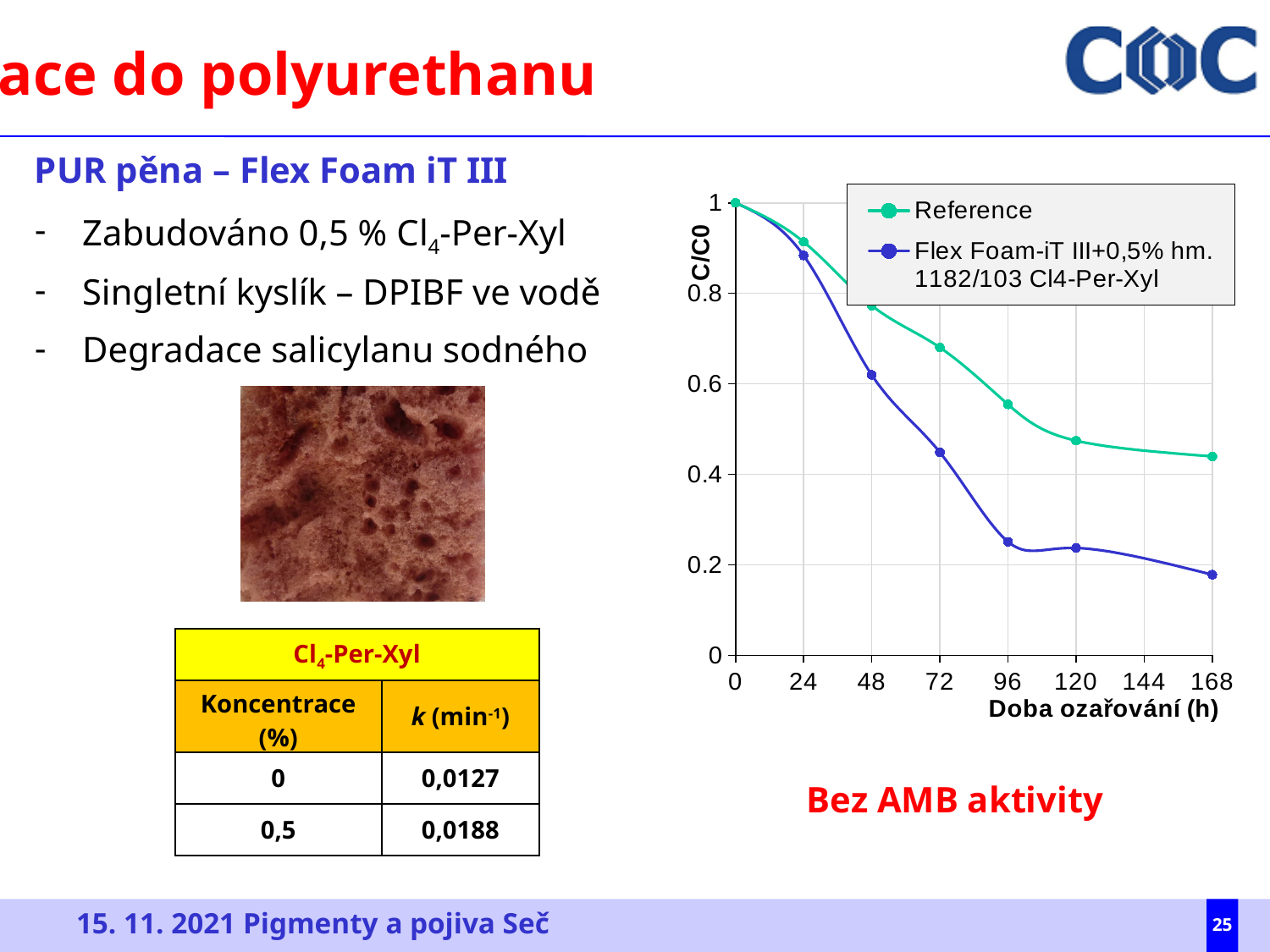
How many data points are plotted for the Reference series? 7 Is the C/C0 value of the Flex Foam-iT III+0,5% hm. 1182/103 Cl4-Per-Xyl series at 168 h greater or less than 0.2? less At 96 h, which series has the higher C/C0 value, Reference or Flex Foam-iT III+0,5% hm. 1182/103 Cl4-Per-Xyl? Reference Does the C/C0 value of the Reference series rise or fall as the irradiation time increases? fall What is the C/C0 value of both series at 0 h? 1 What is the label of the x axis of the chart? Doba ozařování (h) Is the C/C0 value of the Reference series at 48 h greater or less than 0.8? less What is the label of the y axis of the chart? C/C0 Is the C/C0 value of the Reference series at 168 h greater or less than 0.4? greater How many series does the chart legend list? 2 What kind of chart is shown on the slide? line chart